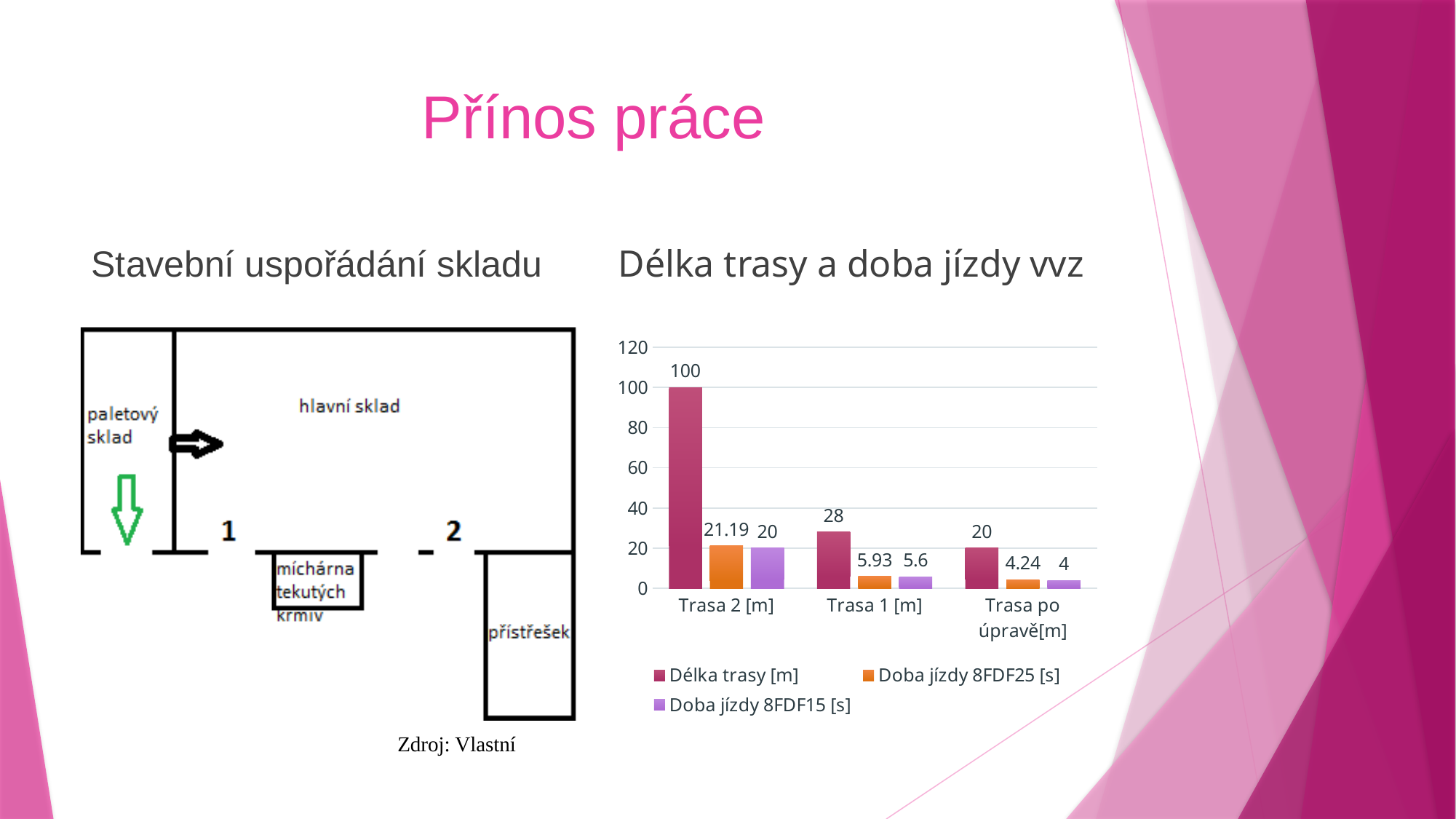
Is the value of Délka trasy [m] for Trasa 1 [m] greater or less than 40? less What is the value of Délka trasy [m] for Trasa 2 [m]? 100 Which category has the lowest Doba jízdy 8FDF25 [s] value? Trasa po úpravě[m] Which category has the highest Délka trasy [m] value? Trasa 2 [m] What is the value of Doba jízdy 8FDF25 [s] for Trasa 1 [m]? 5.93 What is the value of Doba jízdy 8FDF15 [s] for Trasa po úpravě[m]? 4 How many series does the chart legend list? 3 What is the difference between Délka trasy [m] for Trasa 2 [m] and for Trasa 1 [m]? 72 Which is larger: Doba jízdy 8FDF25 [s] for Trasa 2 [m] or Doba jízdy 8FDF15 [s] for Trasa 2 [m]? Doba jízdy 8FDF25 [s] How many categories are shown on the x axis of the chart? 3 What kind of chart is shown on the slide? bar chart What is the title of the chart on the slide? Délka trasy a doba jízdy vvz